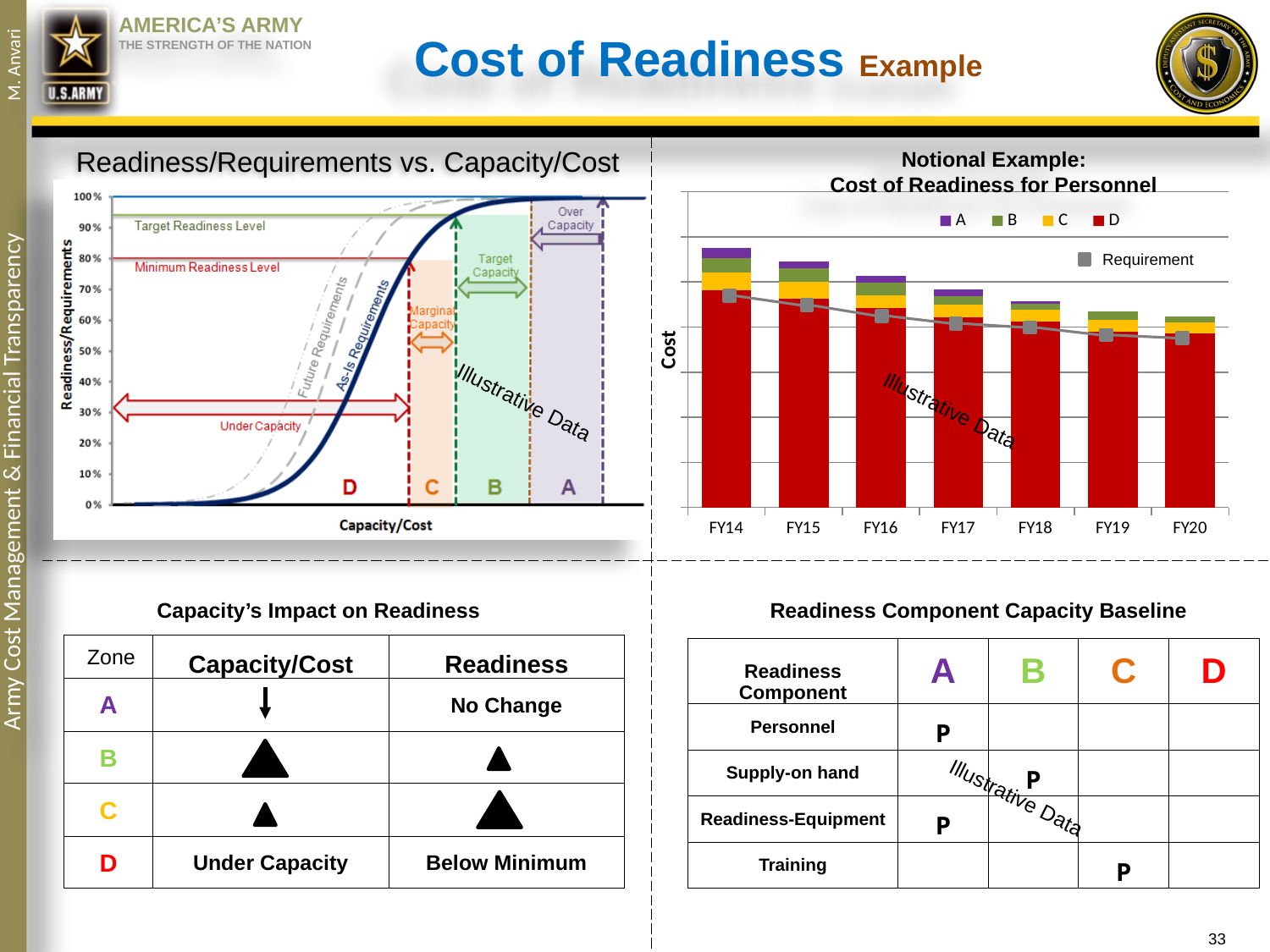
In the 'Notional Example: Cost of Readiness for Personnel' chart, what is the label of the y axis? Cost In the 'Notional Example: Cost of Readiness for Personnel' chart, what are the legend entries for the stacked bars? A, B, C, D In the 'Readiness/Requirements vs. Capacity/Cost' chart, which is higher, the Target Readiness Level or the Minimum Readiness Level? Target Readiness Level In the 'Notional Example: Cost of Readiness for Personnel' chart, how many series does the legend list for the stacked bars? 4 In the 'Readiness/Requirements vs. Capacity/Cost' chart, is the Target Readiness Level greater or less than 50%? greater In the 'Notional Example: Cost of Readiness for Personnel' chart, which fiscal year has the shortest stacked bar? FY20 In the 'Notional Example: Cost of Readiness for Personnel' chart, what kind of chart is used? Stacked bar chart What is the title of the chart on the right side of the slide? Notional Example: Cost of Readiness for Personnel In the 'Notional Example: Cost of Readiness for Personnel' chart, how many fiscal years are shown on the x axis? 7 In the 'Notional Example: Cost of Readiness for Personnel' chart, which fiscal year has the tallest stacked bar? FY14 In the 'Notional Example: Cost of Readiness for Personnel' chart, do the total bar heights rise or fall from FY14 to FY20? Fall